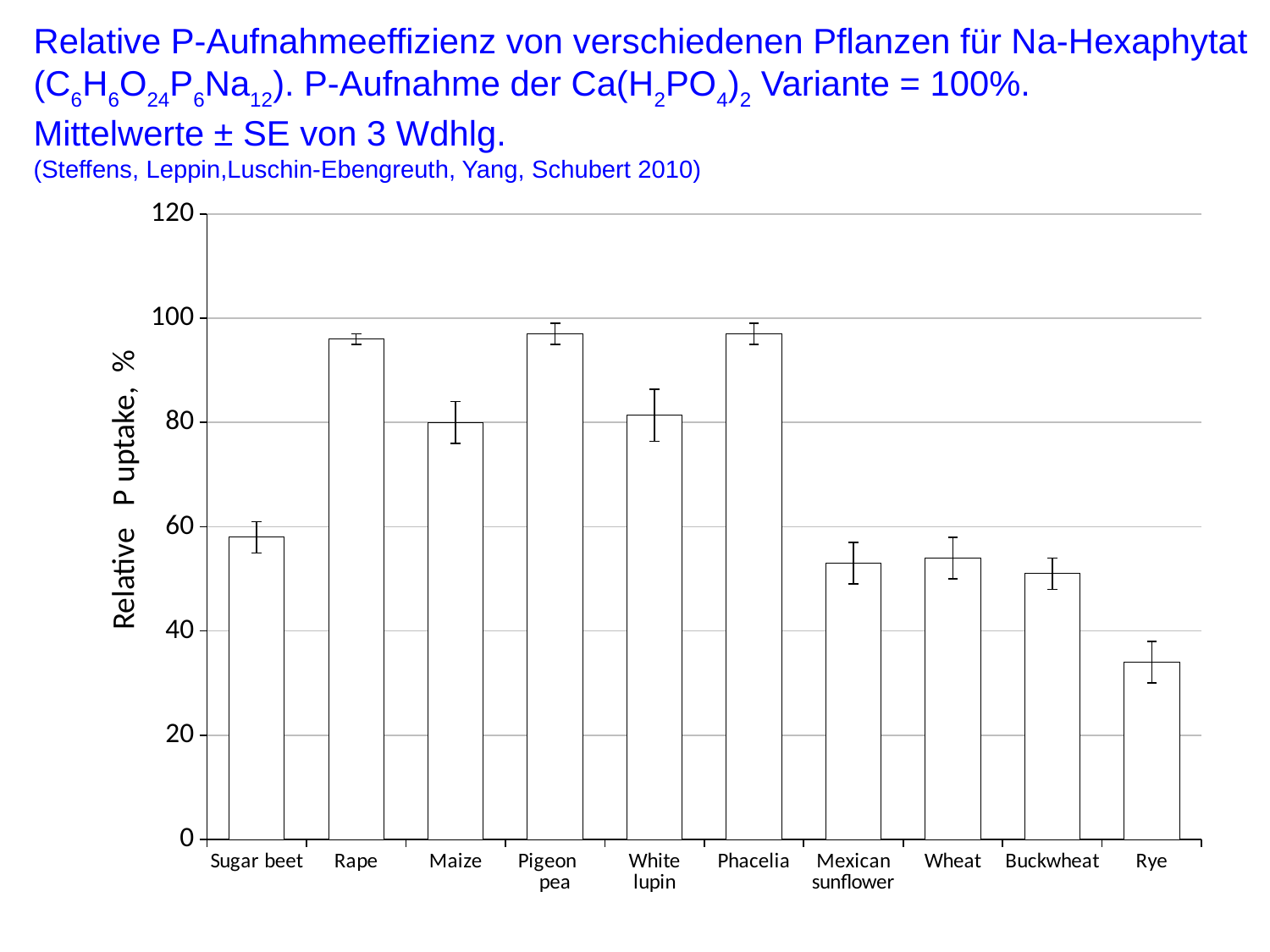
What is the label of the y axis of the chart? Relative P uptake, % Is the value for Rye greater or less than 40? less What kind of chart is shown on the slide? bar chart Which has a higher relative P uptake, Rape or Sugar beet? Rape Is the value for Rape greater or less than 80? greater Is the value for Phacelia greater or less than 100? less Which has a higher relative P uptake, Maize or Buckwheat? Maize How many plant categories are shown on the x axis of the chart? 10 Which has a higher relative P uptake, Wheat or Rye? Wheat Which plant has the lowest relative P uptake in the chart? Rye